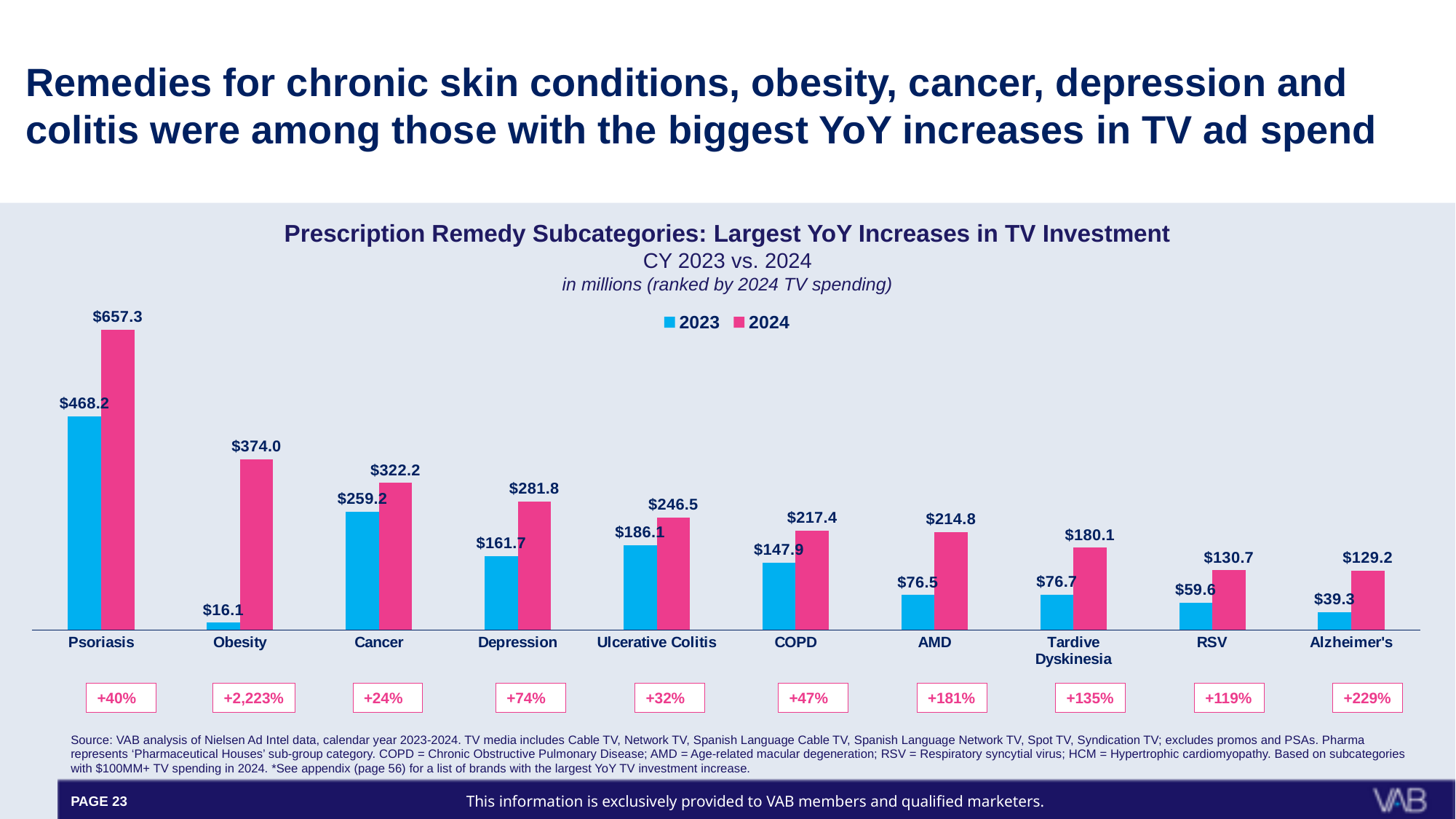
What YoY percentage increase is shown for Obesity? +2,223% What is the difference between the 2024 and 2023 TV investment for Cancer? $63.0 How many series does the legend list? 2 What was the 2024 TV investment for Psoriasis? $657.3 What was the 2023 TV investment for Obesity? $16.1 What kind of chart is shown on the slide? Bar chart Which subcategory had the lowest 2023 TV investment? Obesity What was the 2024 TV investment for Ulcerative Colitis? $246.5 Which had a larger 2024 TV investment, COPD or AMD? COPD Which colour represents the 2024 series in the chart? Pink How many subcategories are shown on the chart? 10 Which subcategory had the highest 2024 TV investment? Psoriasis